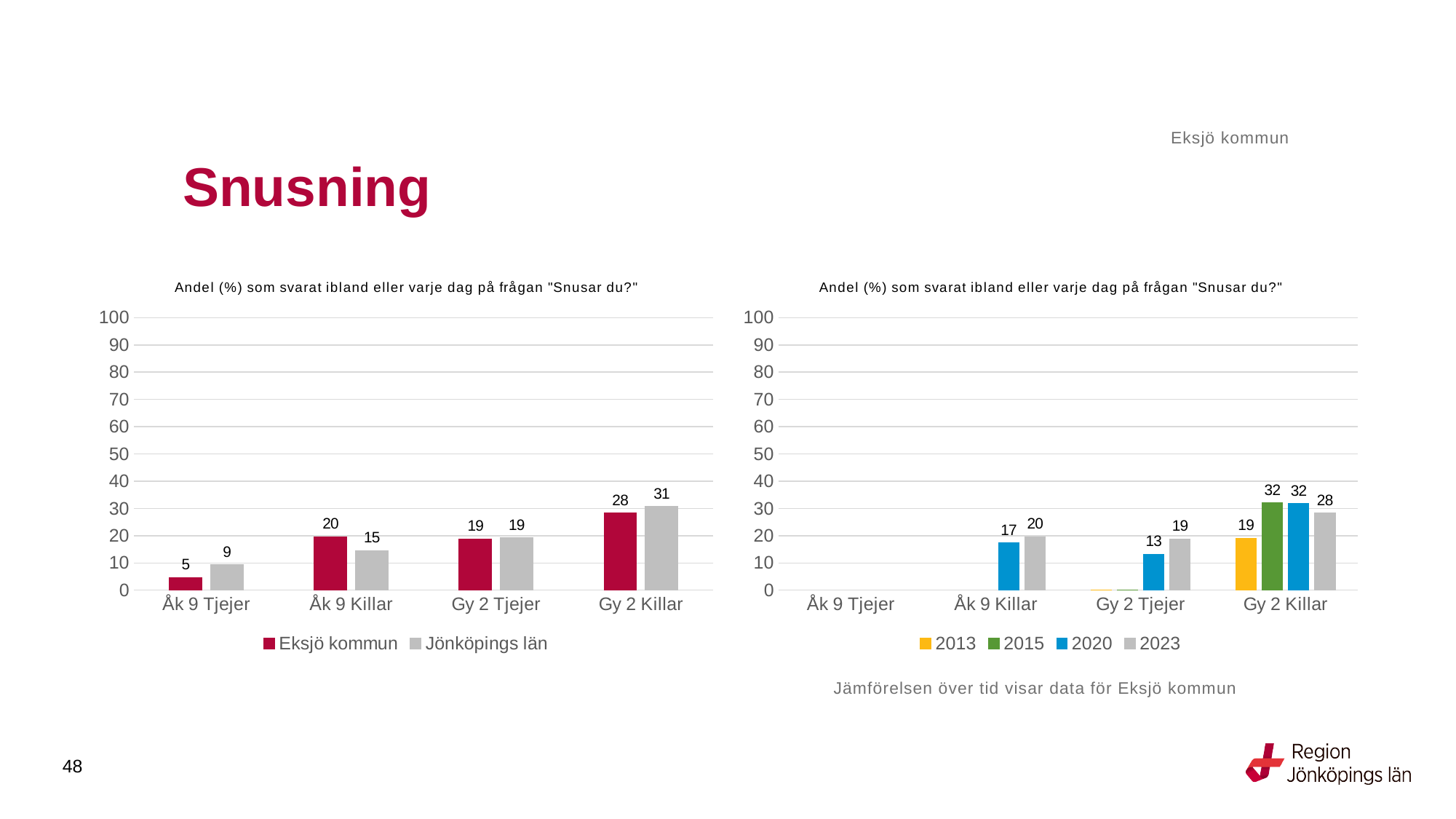
What kind of chart is the right chart? Bar chart In the left chart, how many series does the legend list? 2 In the right chart, what is the value for 2023 for Gy 2 Tjejer? 19 In the right chart, what is the difference between 2020 and 2023 for Åk 9 Killar? 3 In the right chart, what is the value for 2013 for Gy 2 Killar? 19 In the left chart, which category has the highest value for Eksjö kommun? Gy 2 Killar In the left chart, what is the value for Eksjö kommun for Åk 9 Tjejer? 5 In the left chart, which is larger for Gy 2 Killar: Eksjö kommun or Jönköpings län? Jönköpings län In the left chart, what is the difference between Eksjö kommun and Jönköpings län for Åk 9 Killar? 5 In the left chart, what is the value for Jönköpings län for Gy 2 Killar? 31 In the right chart, how many series does the legend list? 4 In the left chart, which category has the lowest value for Jönköpings län? Åk 9 Tjejer